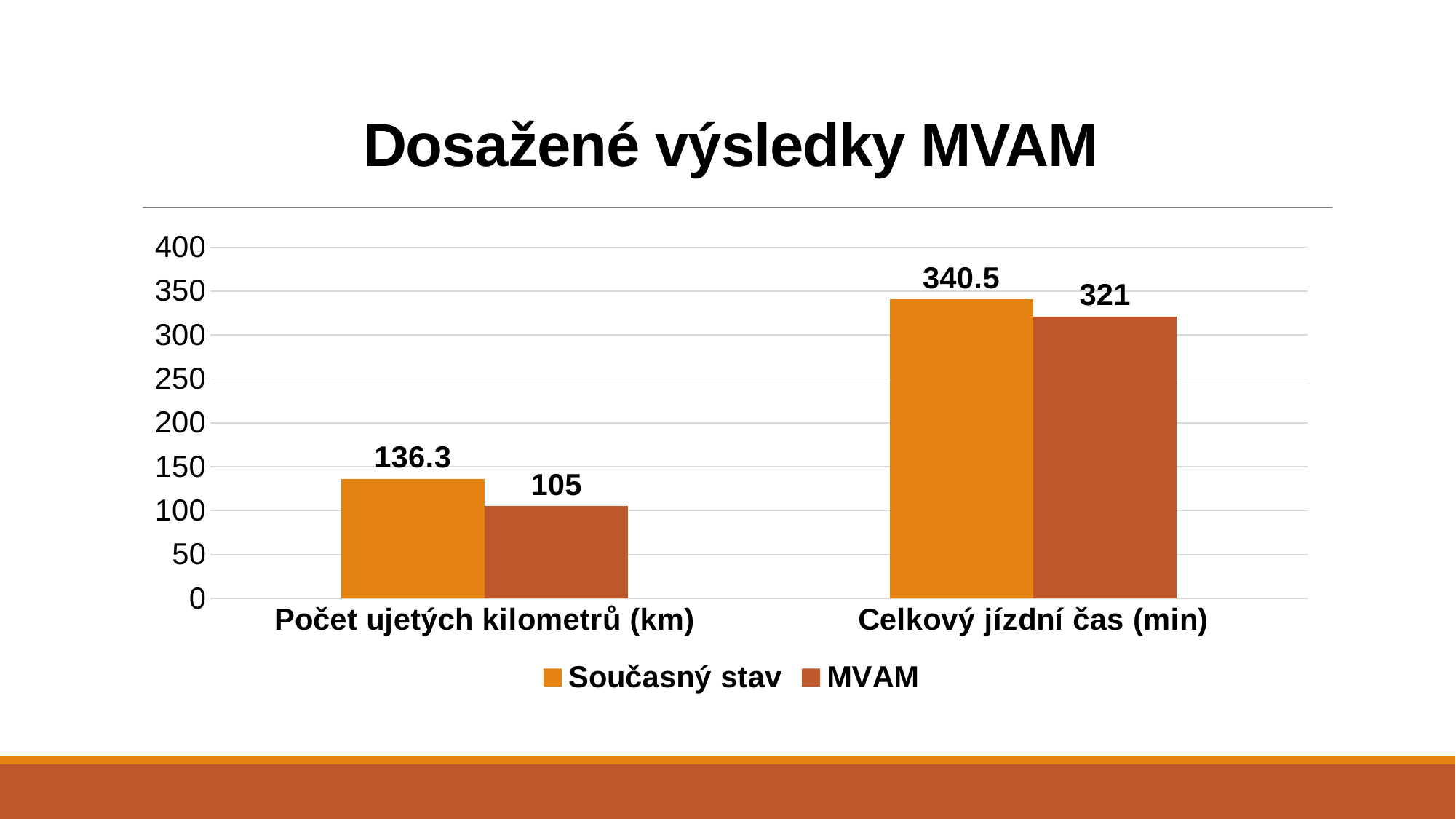
Which series has the larger value for Celkový jízdní čas (min), Současný stav or MVAM? Současný stav What is the value of Současný stav for Celkový jízdní čas (min)? 340.5 Which category has the highest Současný stav value? Celkový jízdní čas (min) What type of chart is shown on the slide? Bar chart What is the difference between Současný stav and MVAM for Celkový jízdní čas (min)? 19.5 How many series does the legend list? 2 What is the value of Současný stav for Počet ujetých kilometrů (km)? 136.3 What is the difference between Současný stav and MVAM for Počet ujetých kilometrů (km)? 31.3 What is the value of MVAM for Celkový jízdní čas (min)? 321 How many categories are shown on the x axis? 2 Which category has the lowest MVAM value? Počet ujetých kilometrů (km) What is the value of MVAM for Počet ujetých kilometrů (km)? 105